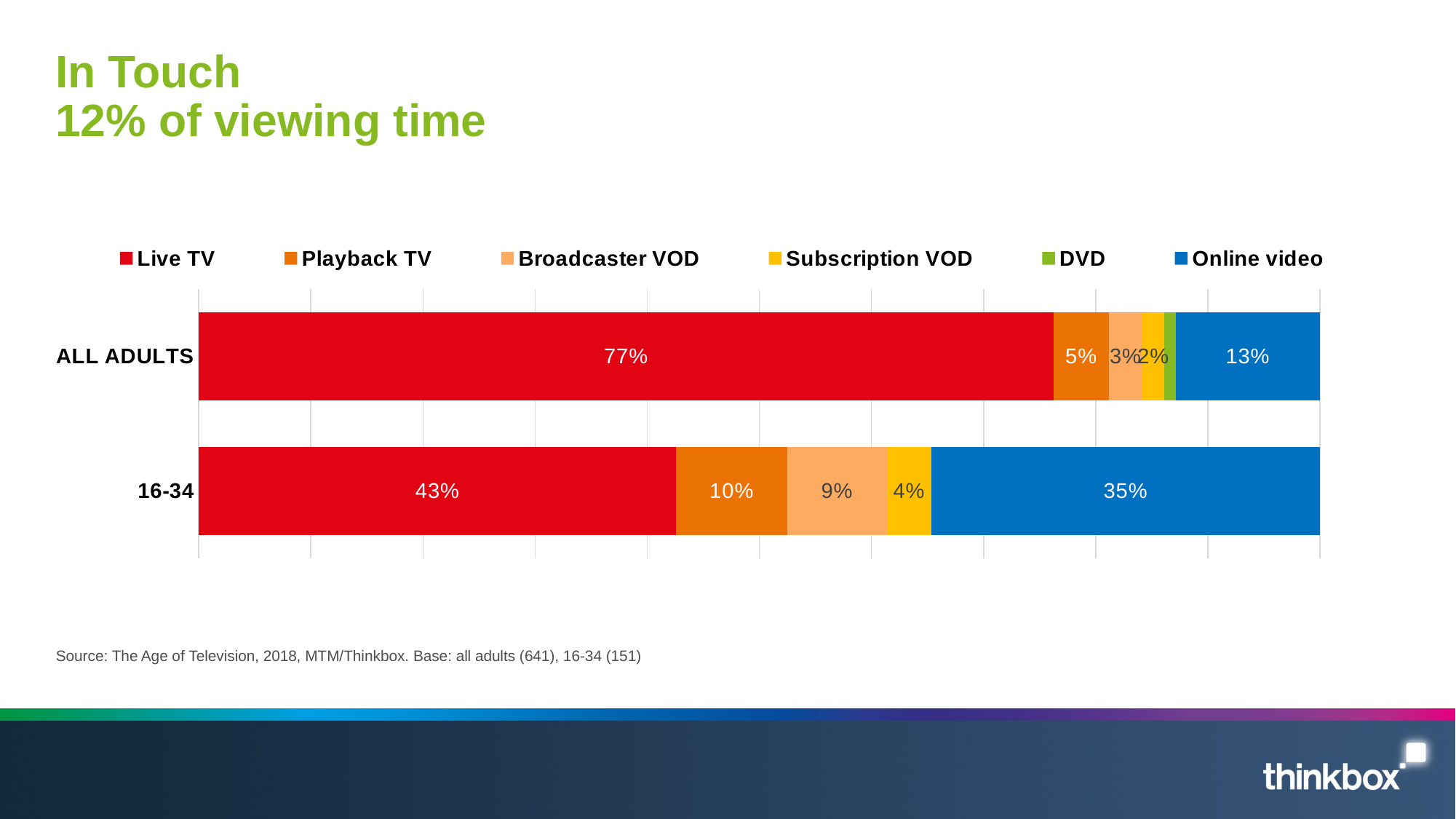
How many series does the legend list? 7 How many percentage points higher is the Live TV share for ALL ADULTS than for the 16-34 group? 34 percentage points What percentage of viewing time is Online video for the 16-34 group? 35% What is the Subscription VOD share for the 16-34 group? 4% Which group has the larger Online video share, ALL ADULTS or 16-34? 16-34 What is the Playback TV share for ALL ADULTS? 5% Which viewing type has the largest share for the 16-34 group? Live TV What is the Broadcaster VOD share for the 16-34 group? 9% What is the Online video share for ALL ADULTS? 13% What kind of chart is shown on the slide? Stacked bar chart What is the Playback TV share for the 16-34 group? 10% What percentage of viewing time is Live TV for ALL ADULTS? 77%